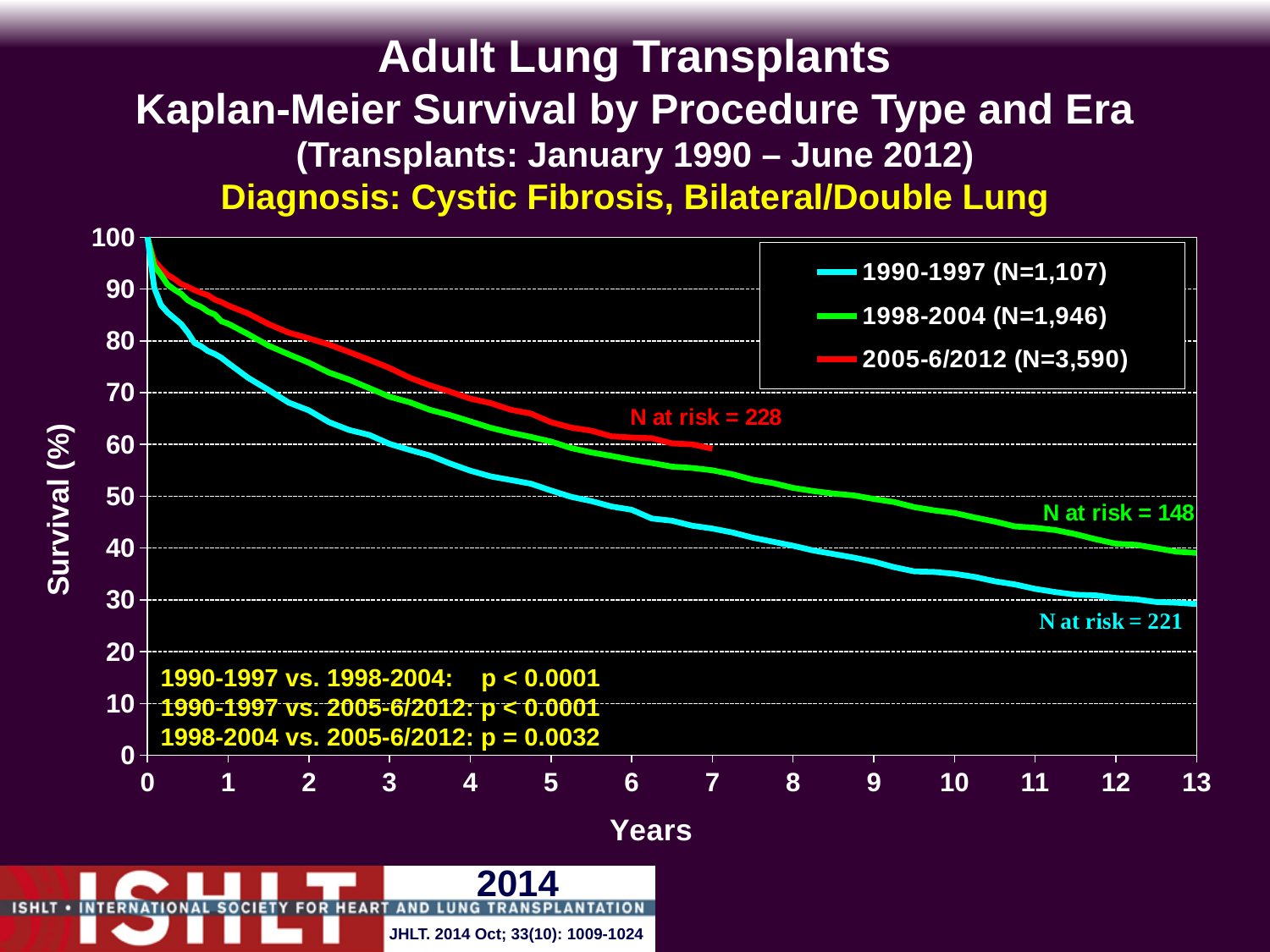
Do the survival curves rise or fall as years increase? fall Is the survival for the 2005-6/2012 era at 5 years greater or less than 60? greater What is the N for the 2005-6/2012 era shown in the legend? 3,590 Is the survival for the 1990-1997 era at 10 years greater or less than 40? less What kind of chart is shown on the slide? line chart What is the N at risk printed for the 1998-2004 (green) curve? 148 How many series does the legend list? 3 What is the N for the 1998-2004 era shown in the legend? 1,946 Which era has the lowest survival at 10 years? 1990-1997 What is the p-value printed for 1998-2004 vs. 2005-6/2012? p = 0.0032 What is the N at risk printed for the 2005-6/2012 (red) curve? 228 Which era has the highest survival at 5 years? 2005-6/2012